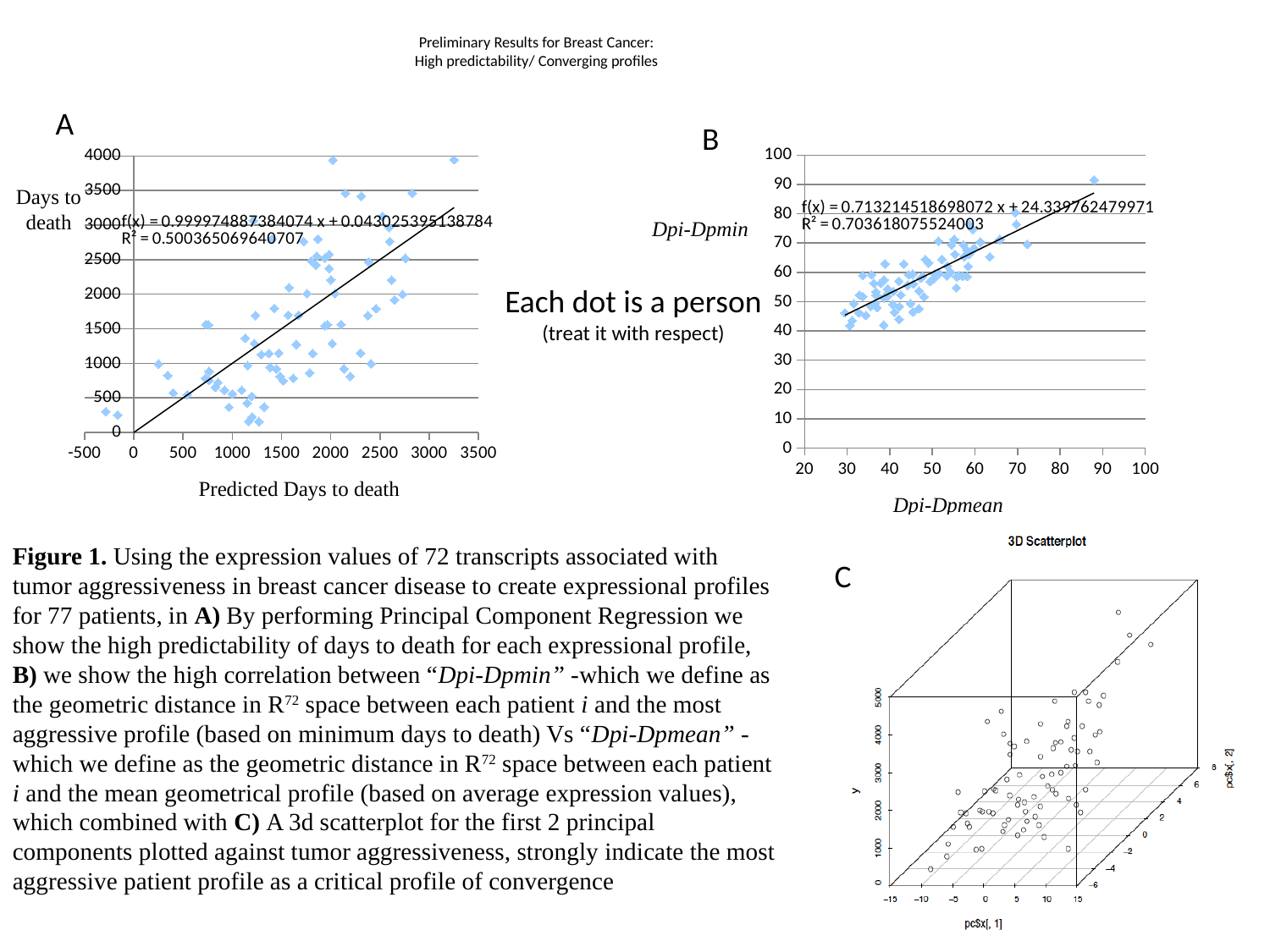
How many charts are shown on the slide? 3 In chart A, what is the trendline equation shown? f(x) = 0.999974887384074 x + 0.043025395138784 In chart A, what is the R² value shown for the trendline? 0.500365069640707 In chart B, is the Dpi-Dpmin value of the highest point greater or less than 80? greater Which chart has the larger R² value, chart A or chart B? chart B In chart B, what is the R² value shown for the trendline? 0.703618075524003 In chart A, what is the label of the x axis? Predicted Days to death What kind of chart is chart A (Days to death vs Predicted Days to death)? scatter plot In chart A, do the plotted values generally rise or fall as Predicted Days to death increases? rise What is the title of chart C (bottom right)? 3D Scatterplot In chart B, do the Dpi-Dpmin values generally rise or fall as Dpi-Dpmean increases? rise In chart B, what is the trendline equation shown? f(x) = 0.713214518698072 x + 24.339762479971